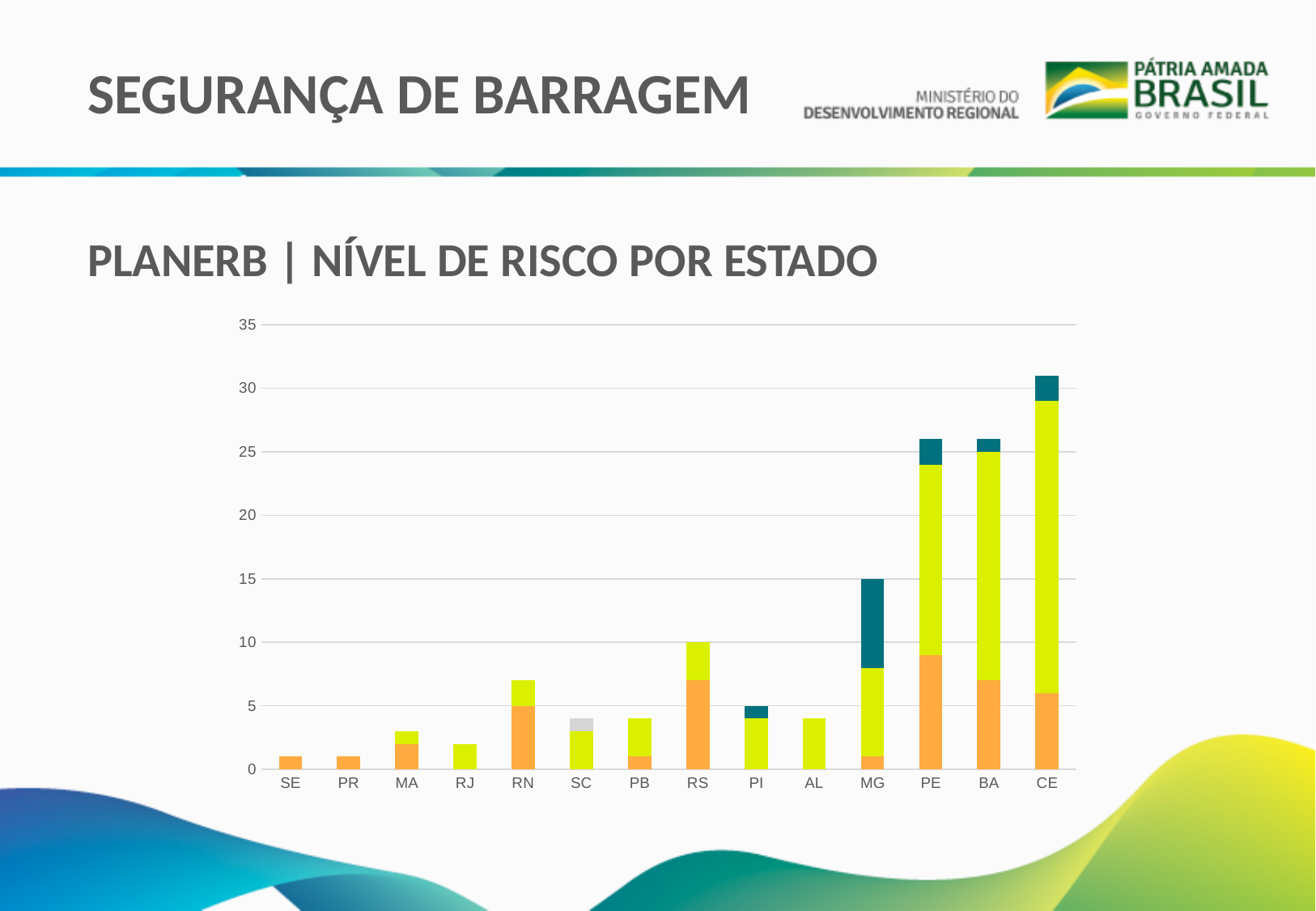
Is the total value for PI greater or less than 10? less Is the total value for CE greater or less than 30? greater Which state has the tallest bar in the chart? CE Is the total value for SC greater or less than 5? less What kind of chart is shown on the slide? Stacked bar chart What is the title of the chart? PLANERB | NÍVEL DE RISCO POR ESTADO Which has a taller bar, MG or RS? MG Do the bar totals generally rise or fall from left to right across the states? rise How many states are shown on the x axis of the chart? 14